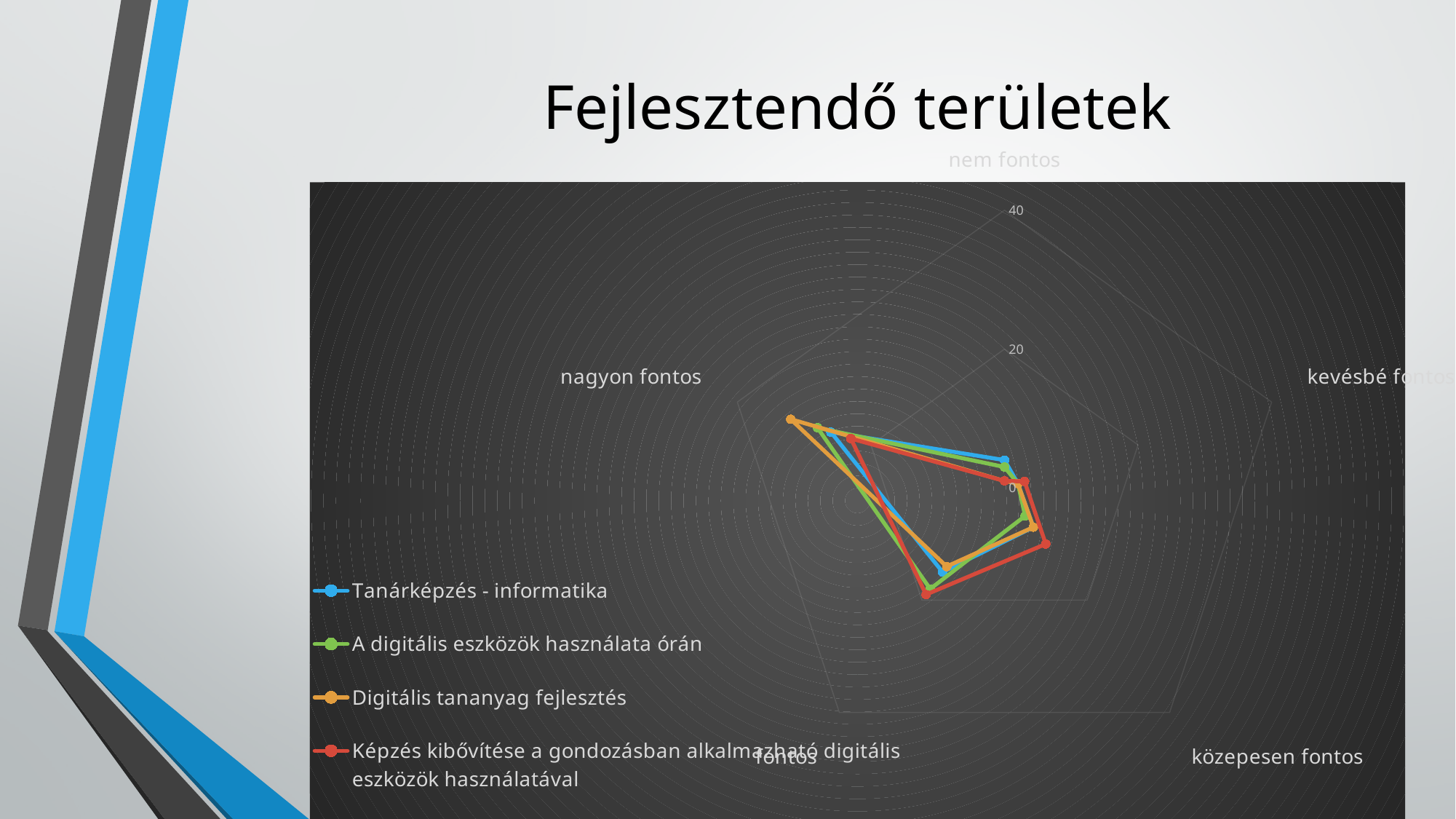
Which colour represents 'Tanárképzés - informatika' in the chart? Blue Which series has the lowest value for 'nagyon fontos'? Képzés kibővítése a gondozásban alkalmazható digitális eszközök használatával How many series does the legend list? 4 How many category axes does the radar chart have? 5 Which series has the highest value for 'fontos'? Képzés kibővítése a gondozásban alkalmazható digitális eszközök használatával Is the value of 'Digitális tananyag fejlesztés' for 'nagyon fontos' greater or less than 20? greater Is the value of 'Képzés kibővítése a gondozásban alkalmazható digitális eszközök használatával' for 'közepesen fontos' greater or less than 20? less What is the title of the chart on the slide? Fejlesztendő területek What kind of chart is shown on the slide? Radar chart Which series has the highest value for 'közepesen fontos'? Képzés kibővítése a gondozásban alkalmazható digitális eszközök használatával Which series has the highest value for 'nagyon fontos'? Digitális tananyag fejlesztés For 'nagyon fontos', which is larger: the value of 'Digitális tananyag fejlesztés' or of 'Képzés kibővítése a gondozásban alkalmazható digitális eszközök használatával'? Digitális tananyag fejlesztés